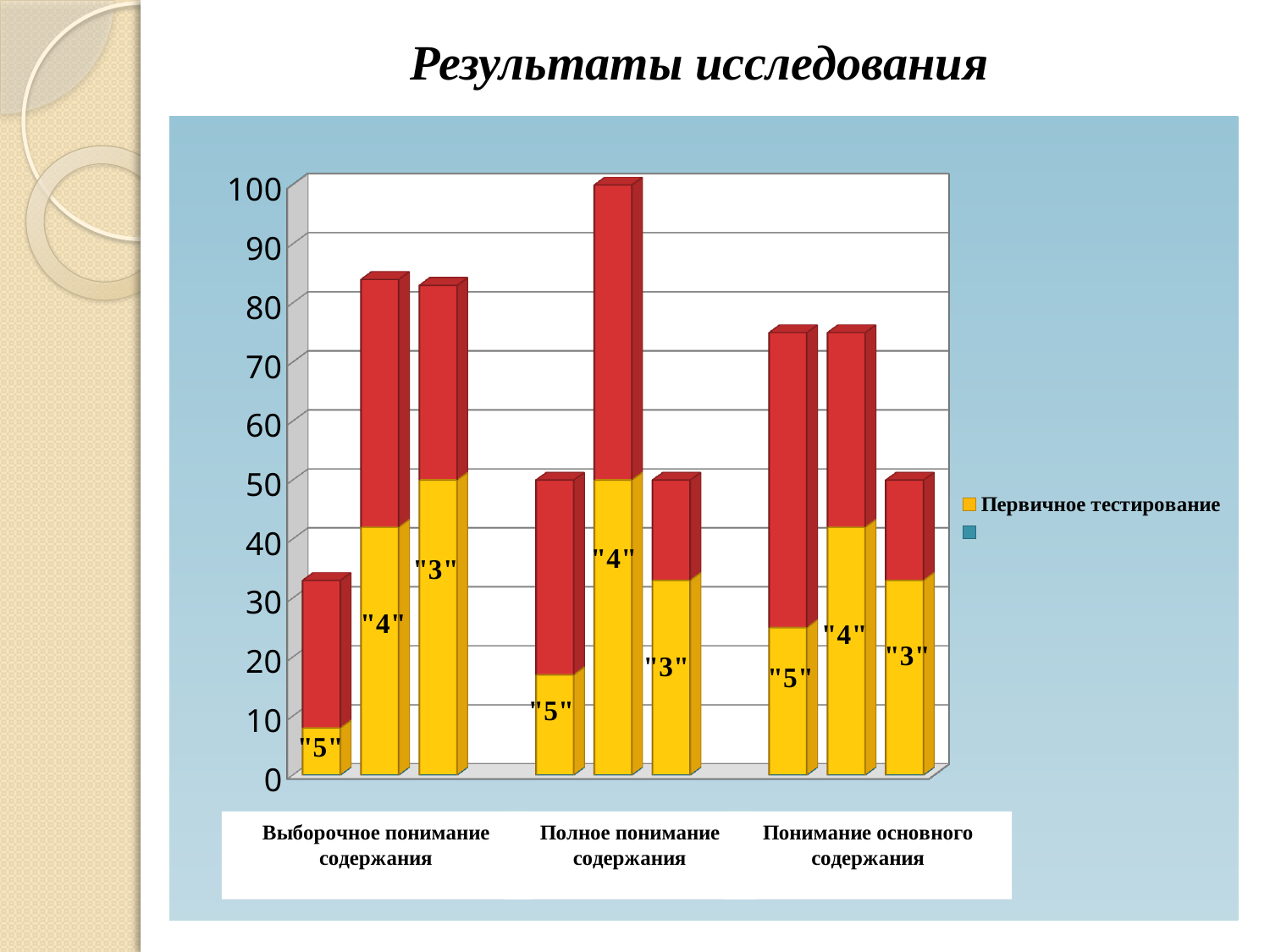
In Понимание основного содержания, which bar is taller, "4" or "3"? "4" What is the name of the series shown in yellow in the legend? Первичное тестирование Which bar is the shortest in the whole chart? "5" in Выборочное понимание содержания Which "5" bar is taller: the one in Полное понимание содержания or the one in Понимание основного содержания? Понимание основного содержания Which bar is the tallest in the whole chart? "4" in Полное понимание содержания What kind of chart is shown on the slide? Stacked bar chart Is the yellow (Первичное тестирование) segment of the "4" bar in Полное понимание содержания greater or less than 40? greater Is the yellow (Первичное тестирование) segment of the "5" bar in Выборочное понимание содержания greater or less than 20? less Is the total height of the "4" bar in Выборочное понимание содержания greater or less than 80? greater How many entries does the chart legend list? 2 How many category groups are labelled along the x axis of the chart? 3